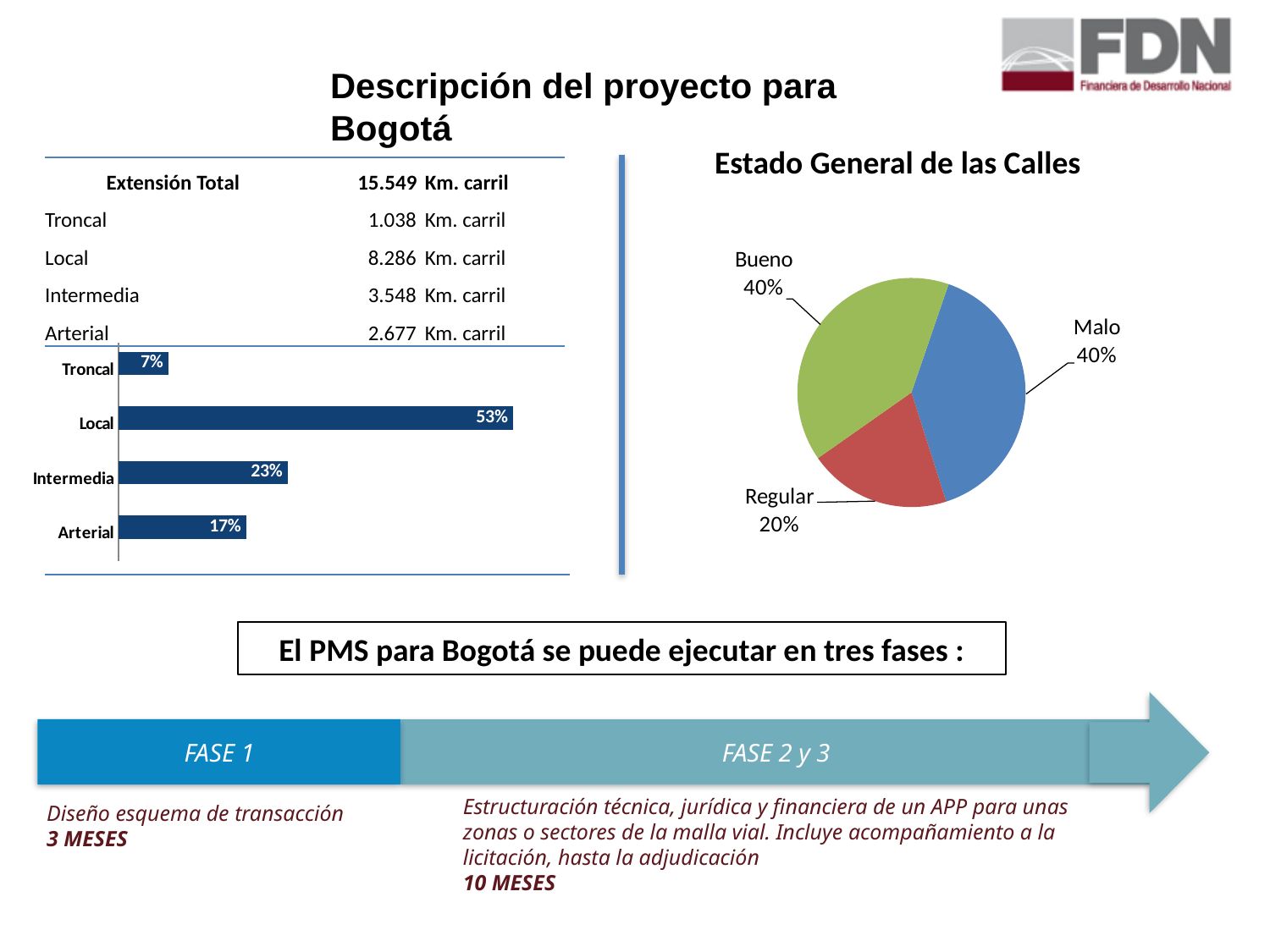
What kind of chart is the chart on the left of the slide? Bar chart How many slices does the 'Estado General de las Calles' pie chart have? 3 In the bar chart on the left of the slide, which category has the lowest value? Troncal How many categories does the bar chart on the left of the slide show? 4 What kind of chart is 'Estado General de las Calles'? Pie chart In the 'Estado General de las Calles' chart, what share of the pie is Bueno? 40% In the bar chart on the left of the slide, what is the value for Troncal? 7% In the bar chart on the left of the slide, what is the value for Local? 53% In the bar chart on the left of the slide, which is larger, the value for Intermedia or the value for Arterial? Intermedia In the bar chart on the left of the slide, what is the difference between the values for Intermedia and Arterial? 6% In the 'Estado General de las Calles' chart, what share of the pie is Regular? 20% In the bar chart on the left of the slide, which category has the highest value? Local